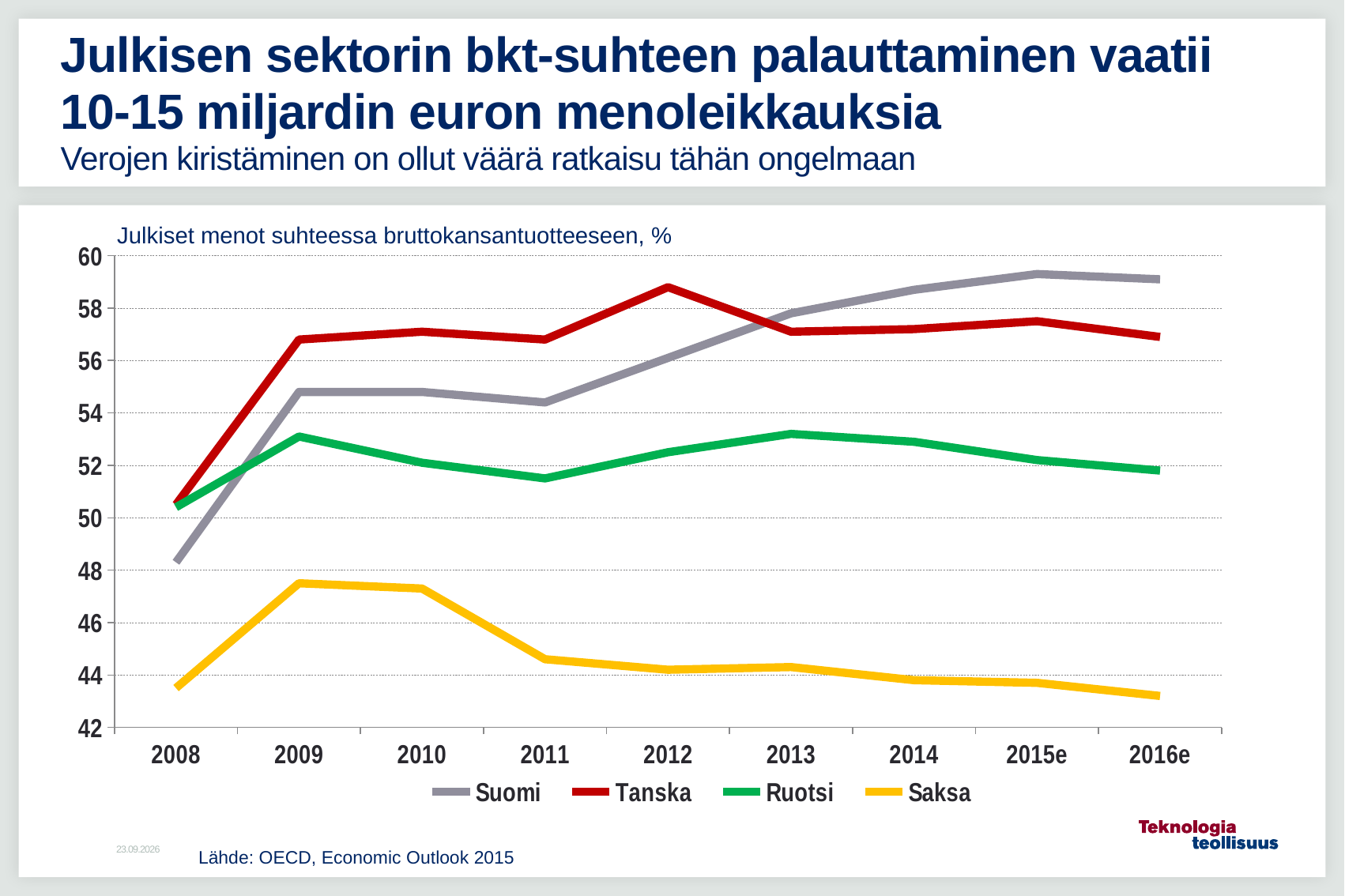
Is the value for Tanska in 2012 greater or less than 58? greater What kind of chart is shown on the slide? line chart Does the Suomi line rise or fall from 2011 to 2015e? rise In which year is Suomi at its lowest value? 2008 Is the value for Suomi in 2008 greater or less than 50? less Which is higher in 2016e, Suomi or Tanska? Suomi How many series does the legend list? 4 What is the title of the chart? Julkiset menot suhteessa bruttokansantuotteeseen, % How many years are shown on the x axis? 9 In which year does Saksa reach its highest value? 2009 Which series has the lowest value in 2016e? Saksa Which series has the highest value in 2012? Tanska